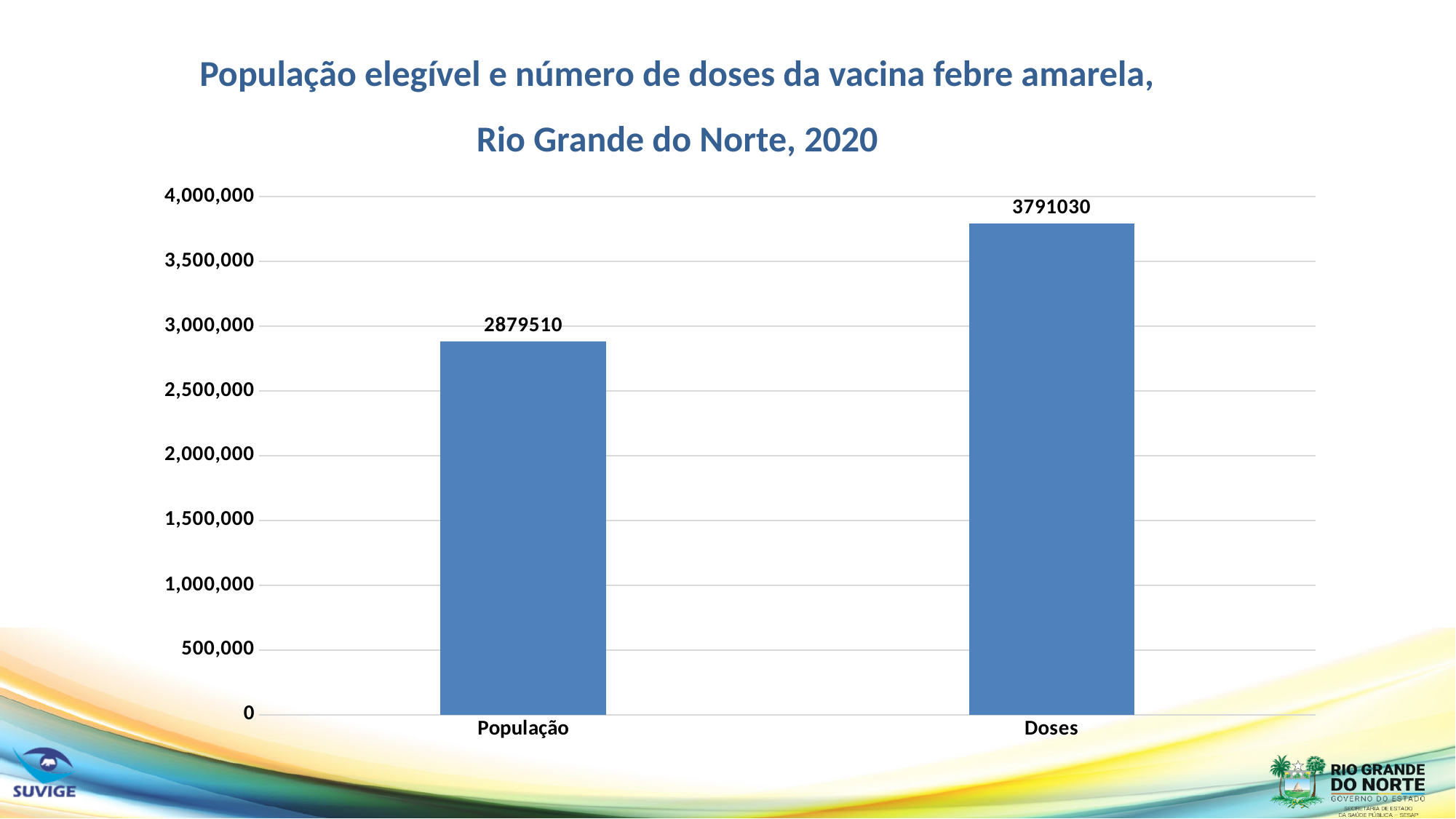
Which category has the highest value? Doses Is the value for População greater or less than 3,000,000? less How many categories are shown on the x axis? 2 Is the value for Doses greater or less than 3,500,000? greater Which category has the lowest value? População What is the title of the chart? População elegível e número de doses da vacina febre amarela, Rio Grande do Norte, 2020 What is the value for População? 2879510 What is the value for Doses? 3791030 What is the difference between the value for Doses and the value for População? 911520 What is the highest value shown on the y axis? 4,000,000 Which is larger, the value for População or the value for Doses? Doses What kind of chart is shown on the slide? bar chart